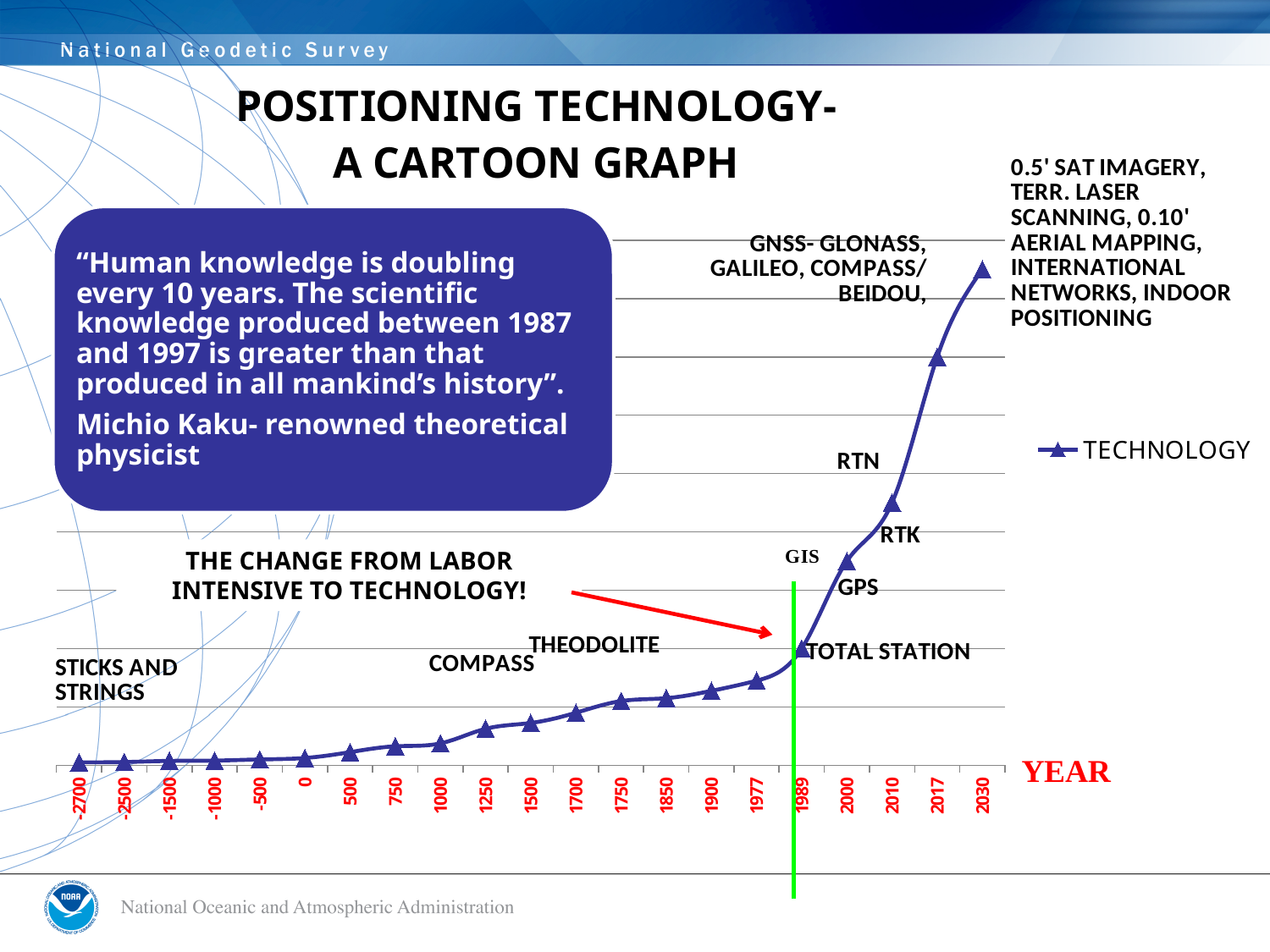
How many year categories are shown along the x axis of the chart? 21 How many series does the chart legend list? 1 Does the TECHNOLOGY line rise or fall as the years increase along the x axis? rises What is the name of the series shown in the chart legend? TECHNOLOGY What is the first year label shown on the x axis of the chart? -2700 What is the title of the x axis of the chart? YEAR Which year on the x axis has the highest value for the TECHNOLOGY series? 2030 Which has the larger TECHNOLOGY value, the year 1989 or the year 2030? 2030 What kind of chart is shown on the slide? line chart Which has the larger TECHNOLOGY value, the year 0 or the year 1977? 1977 Which has the larger TECHNOLOGY value, the year 1500 or the year 2010? 2010